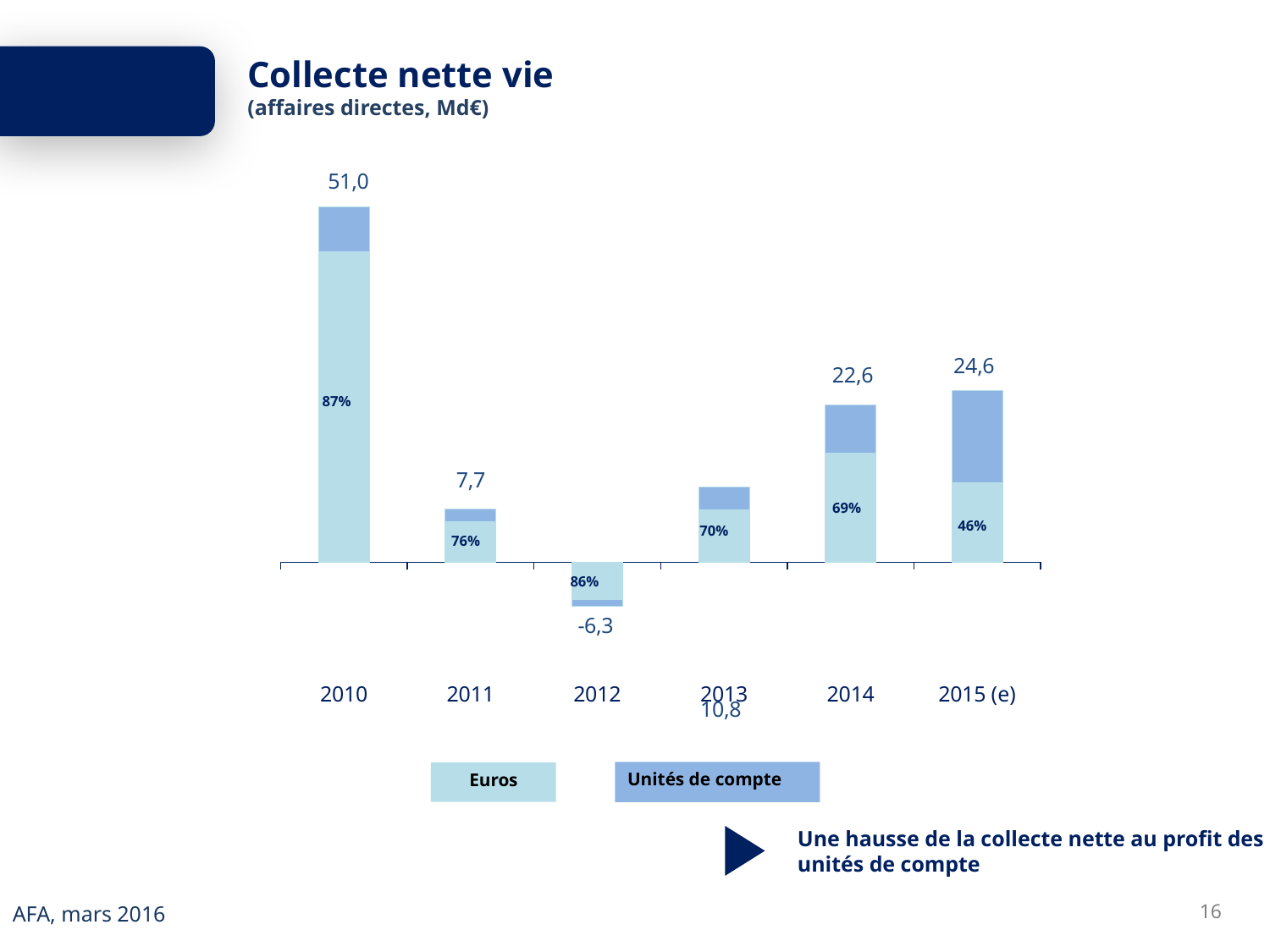
Which year has the highest total net inflow? 2010 What is the difference between the total for 2010 and the total for 2014? 28,4 How many years are shown on the x axis? 6 Which year has the lowest total net inflow? 2012 What percentage share is printed on the Euros segment of the 2010 bar? 87% What percentage share is printed on the Euros segment of the 2015 (e) bar? 46% Which year has the larger total, 2011 or 2013? 2013 What is the total net inflow (collecte nette) shown for 2010? 51,0 What is the total value shown for 2012? -6,3 How many series does the legend list? 2 What kind of chart is shown on the slide? Stacked bar chart What is the total value shown for 2015 (e)? 24,6